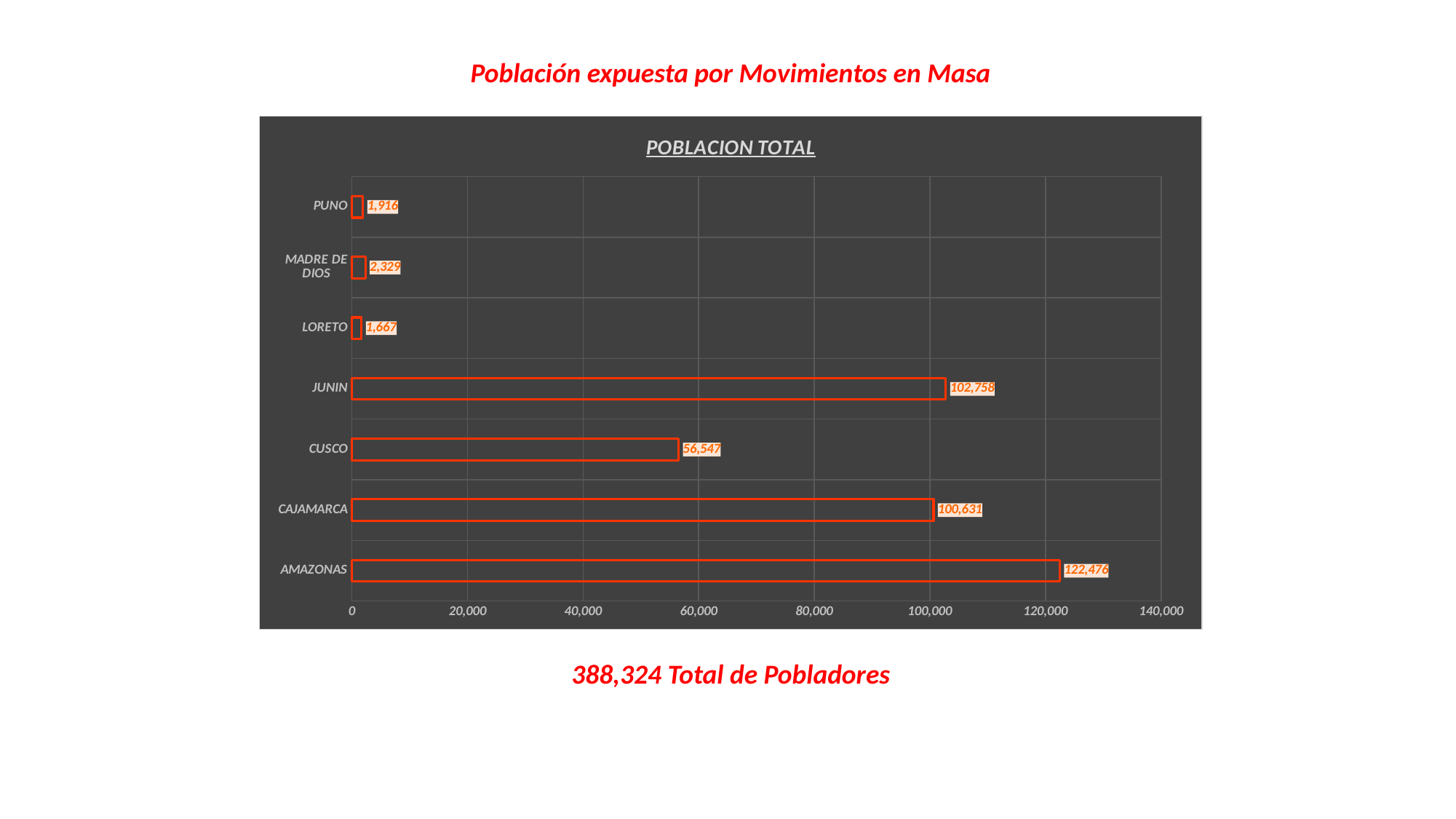
What is the title of the chart? POBLACION TOTAL Is the value for CUSCO greater or less than 60,000? less Which category has the highest value? AMAZONAS Which is larger, the value for JUNIN or the value for CAJAMARCA? JUNIN Which category has the lowest value? LORETO What is the value for JUNIN? 102,758 What kind of chart is shown on the slide? bar chart What is the difference between the values for PUNO and LORETO? 249 What is the value for MADRE DE DIOS? 2,329 What is the difference between the values for AMAZONAS and CAJAMARCA? 21,845 How many categories are shown on the chart? 7 What is the value for CUSCO? 56,547